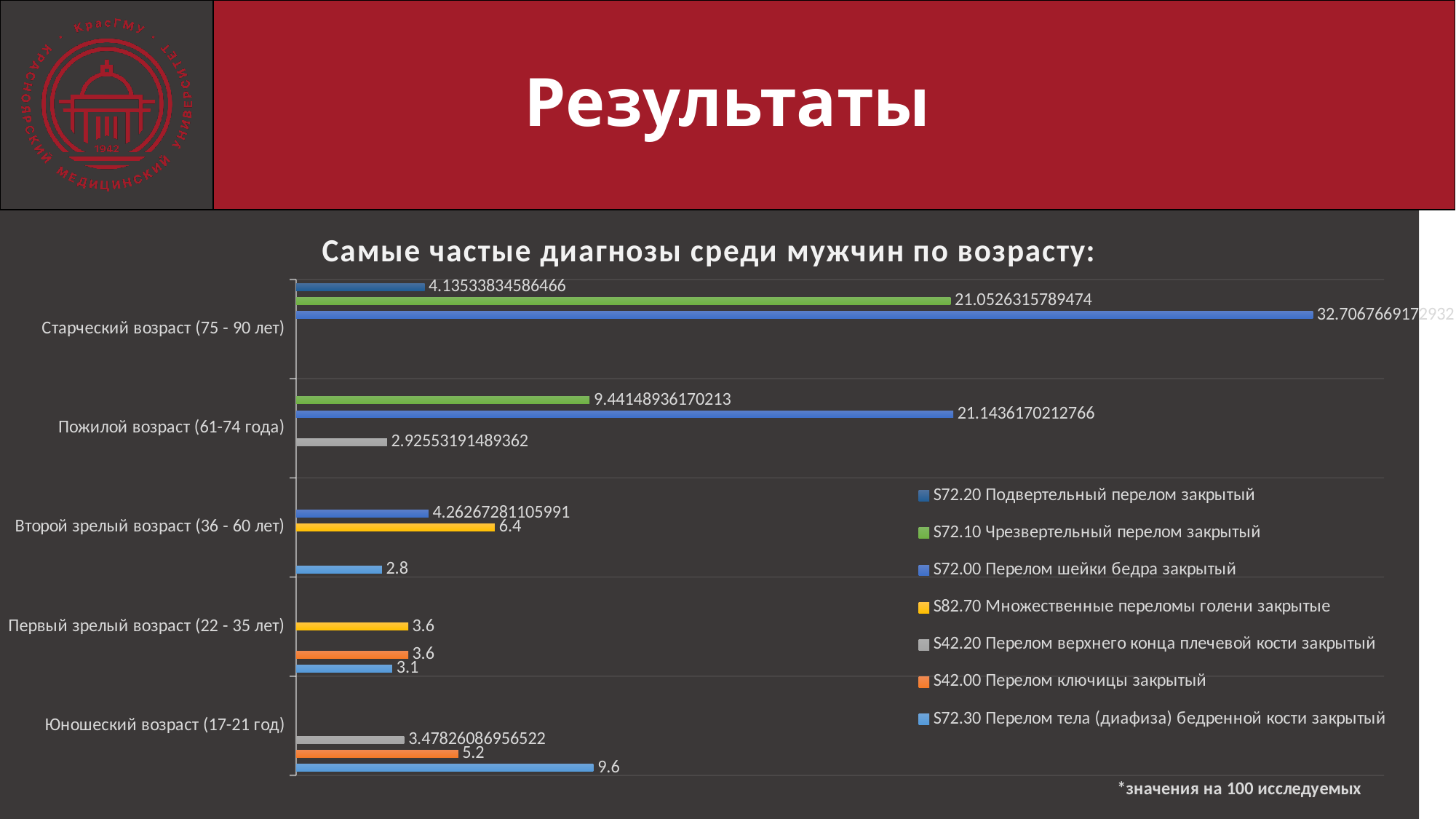
What is the value for S72.30 Перелом тела (диафиза) бедренной кости закрытый in the Юношеский возраст (17-21 год) category? 9.6 What is the value for S72.00 Перелом шейки бедра закрытый in the Пожилой возраст (61-74 года) category? 21.1436170212766 Which series has the highest value in the Юношеский возраст (17-21 год) category? S72.30 Перелом тела (диафиза) бедренной кости закрытый What type of chart is shown on the slide? bar chart How many series does the chart legend list? 7 How many age categories are shown on the chart? 5 Which series has the lowest value in the Пожилой возраст (61-74 года) category? S42.20 Перелом верхнего конца плечевой кости закрытый What is the difference between the S72.30 value in the Юношеский возраст (17-21 год) category and the S42.00 value in the same category? 4.4 What is the value for S72.10 Чрезвертельный перелом закрытый in the Старческий возраст (75 - 90 лет) category? 21.0526315789474 What is the title of the chart? Самые частые диагнозы среди мужчин по возрасту: In the Второй зрелый возраст (36 - 60 лет) category, which is larger: the value for S82.70 or the value for S72.30? S82.70 What is the value for S82.70 Множественные переломы голени закрытые in the Второй зрелый возраст (36 - 60 лет) category? 6.4